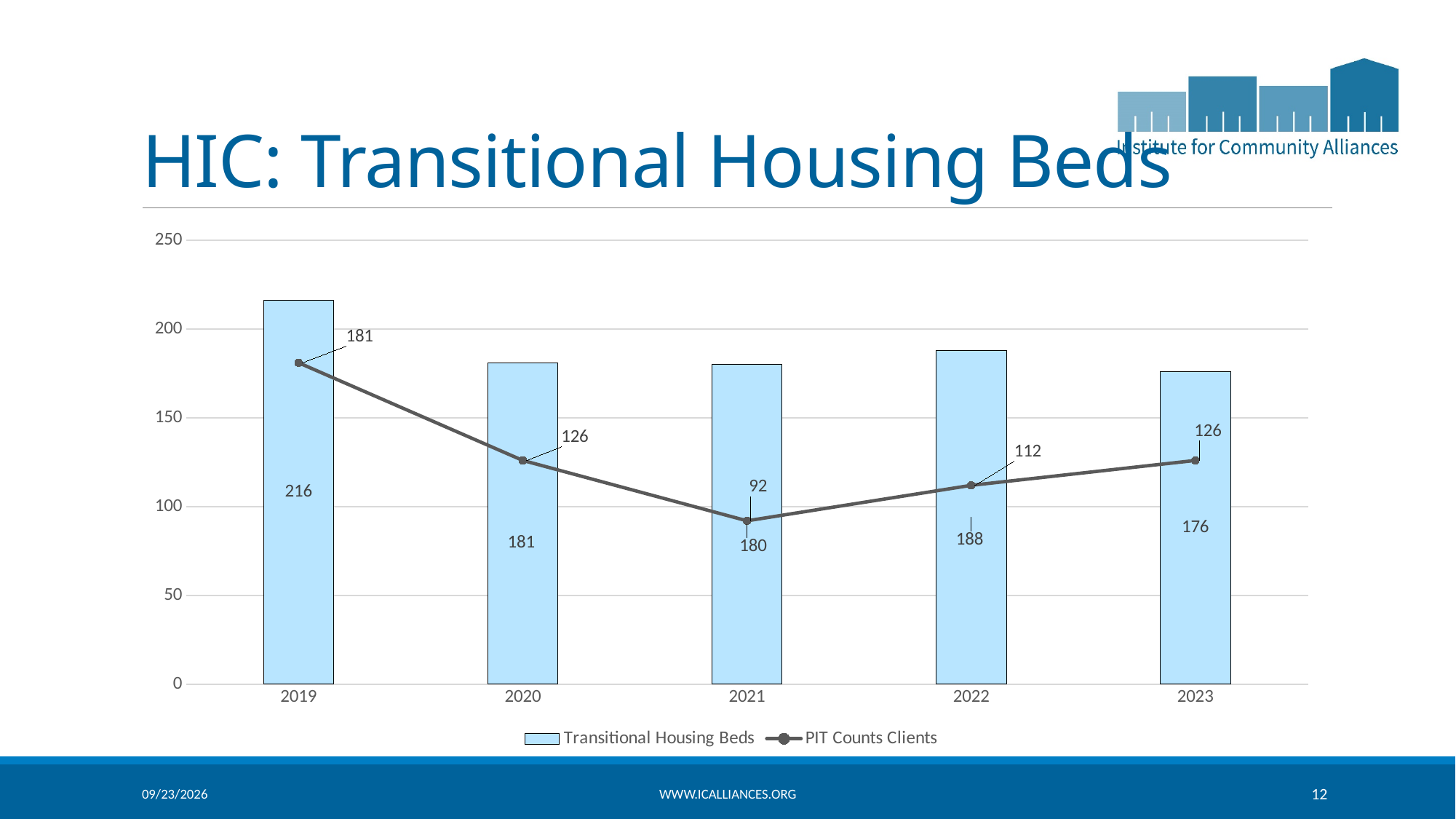
Does the PIT Counts Clients line rise or fall from 2019 to 2021? fall How many Transitional Housing Beds were there in 2019? 216 How many series does the legend list? 2 Which year had the lowest number of Transitional Housing Beds? 2023 What kind of chart is shown on the slide? Combined bar and line chart What was the PIT Counts Clients value in 2021? 92 What was the PIT Counts Clients value in 2022? 112 Which is larger: Transitional Housing Beds in 2022 or in 2020? 2022 What is the difference between Transitional Housing Beds and PIT Counts Clients in 2021? 88 How many years are shown on the x axis? 5 Is the PIT Counts Clients value for 2023 greater or less than 150? less Which year had the highest PIT Counts Clients value? 2019